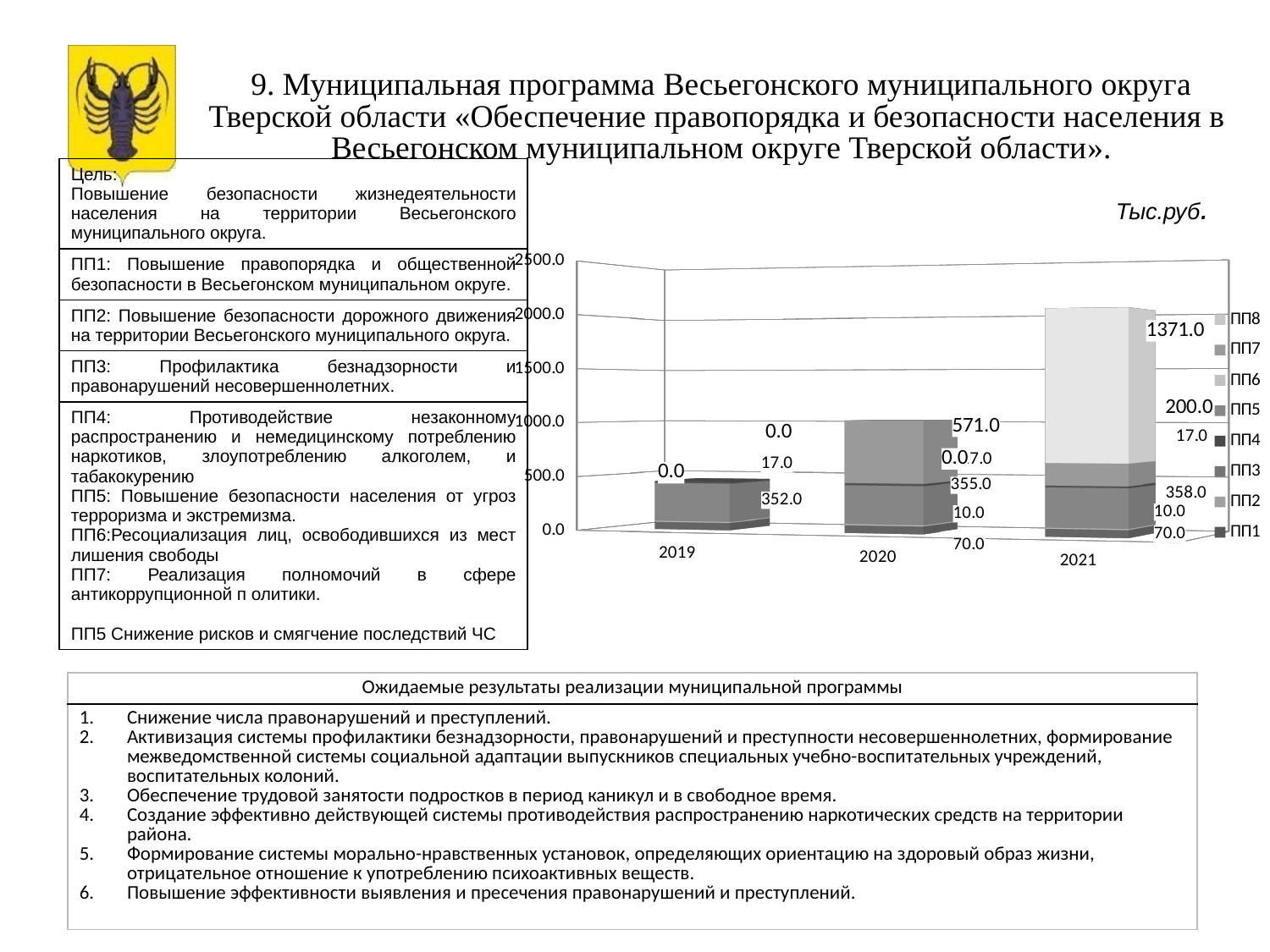
Which year has the shortest stacked bar in the chart? 2019 What value is labelled on the bottom segment of the 2021 bar? 70.0 Do the stacked bar totals rise or fall from 2019 to 2021? rise What kind of chart is shown on the slide? bar chart What unit is indicated above the chart? Тыс.руб. Which year has the tallest stacked bar in the chart? 2021 What is the largest data label shown on the 2020 bar? 571.0 Is the total height of the 2019 bar greater or less than 500.0? less How many years (categories) are shown on the x axis of the chart? 3 Is the total height of the 2021 bar greater or less than 1500.0? greater How many series does the chart legend list? 8 What is the largest data label shown on the 2021 bar? 1371.0